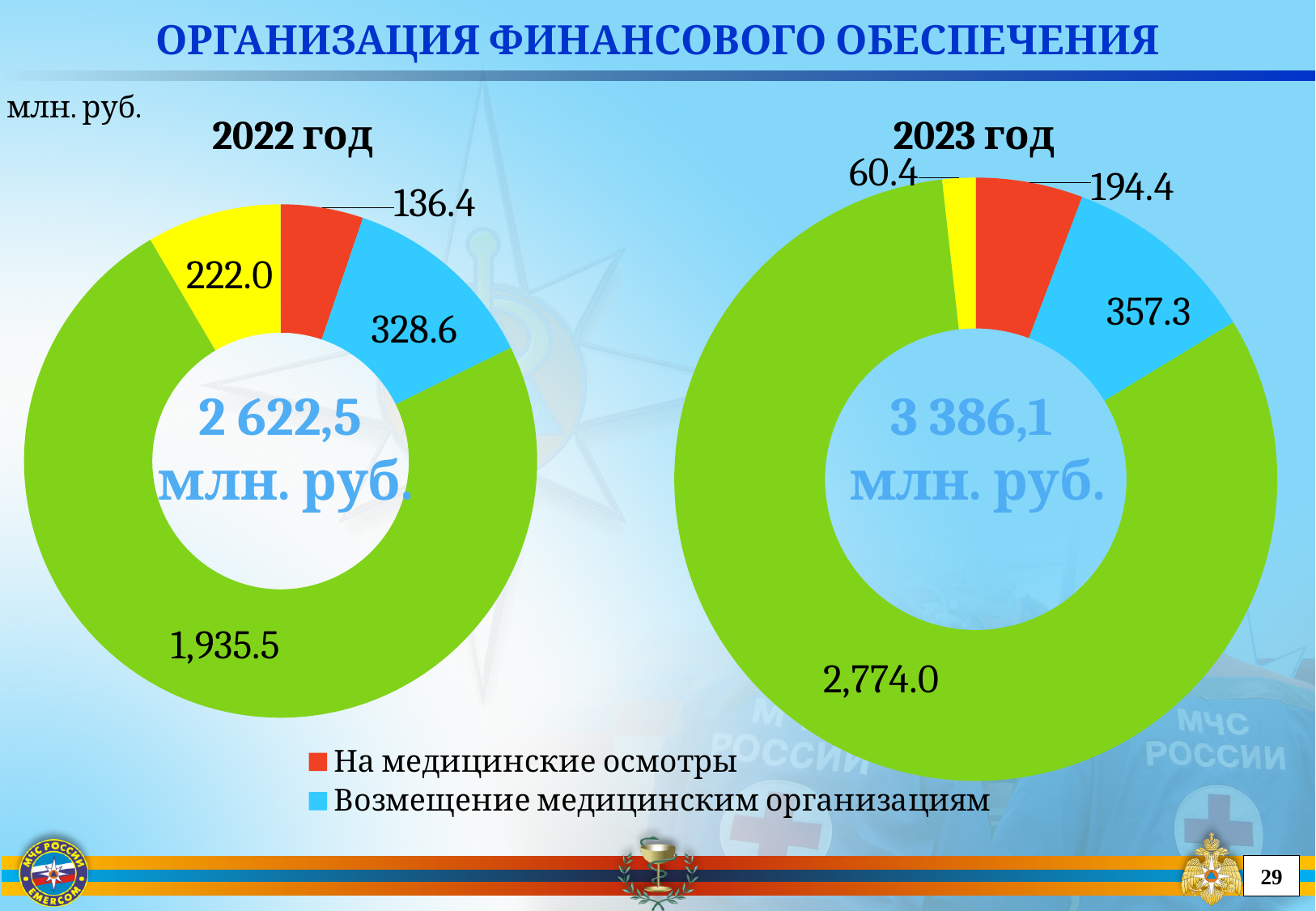
What total is shown in the centre of the 2023 год chart? 3 386,1 млн. руб. In the 2022 год chart, what is the value for На медицинские осмотры? 136.4 In the 2022 год chart, what is the value of the smallest slice? 136.4 In the 2023 год chart, what is the value of the yellow slice? 60.4 Which chart shows the larger value for Возмещение медицинским организациям, 2022 год or 2023 год? 2023 год How many slices does the 2022 год chart have? 4 How much larger is the value for На медицинские осмотры in the 2023 год chart than in the 2022 год chart? 58.0 How many entries does the legend list? 2 What kind of chart is used for 2022 год and 2023 год? pie (doughnut) chart In the 2023 год chart, what is the value for Возмещение медицинским организациям? 357.3 In the 2023 год chart, what is the value of the largest slice? 2,774.0 In the 2022 год chart, what is the value for Возмещение медицинским организациям? 328.6